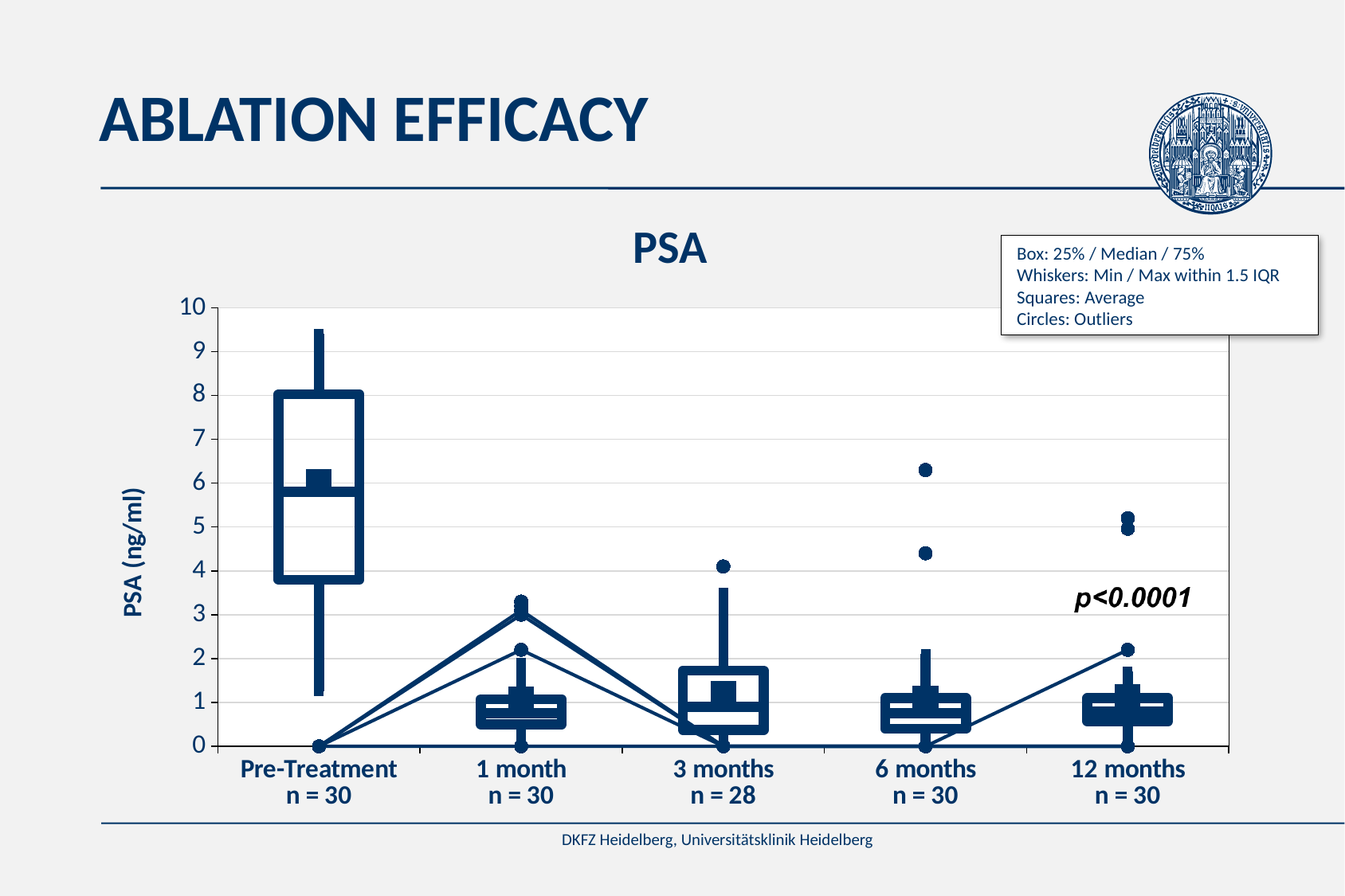
Does the median PSA rise or fall from Pre-Treatment to 1 month? fall What is the sample size (n) at 3 months? n = 28 Is the median PSA at Pre-Treatment greater or less than 5? greater Is the median PSA at 1 month greater or less than 2? less Is the highest outlier at 6 months greater or less than 6? greater What kind of chart is shown on the slide? box plot Which time point has the smallest sample size? 3 months What is the sample size (n) at Pre-Treatment? n = 30 What p-value is printed on the chart? p<0.0001 How many time points (categories) are shown on the x axis? 5 Which time point has the highest median PSA? Pre-Treatment What is the label of the y axis? PSA (ng/ml)